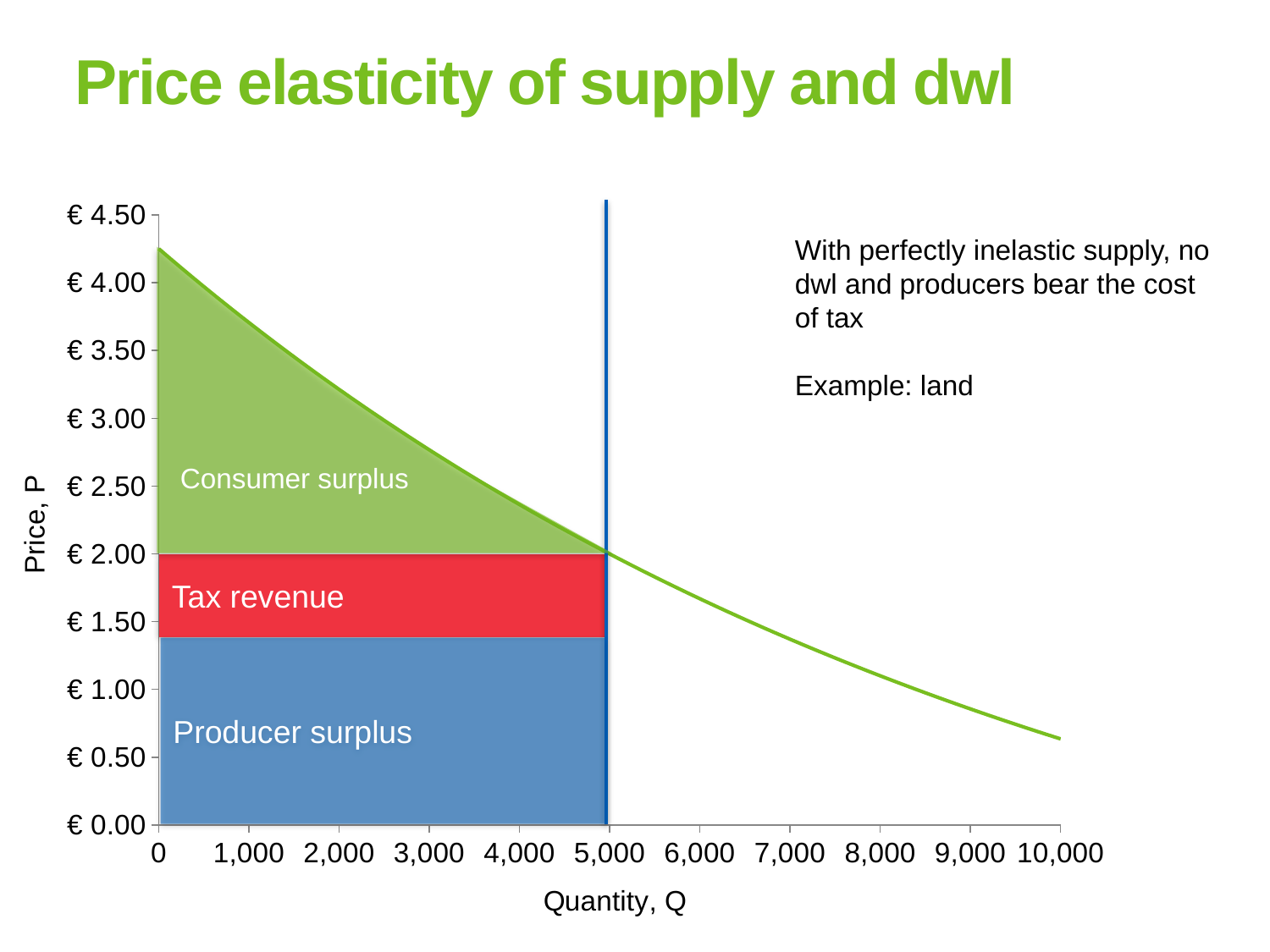
At what price does the green demand curve cross the vertical supply line? € 2.00 Does the green demand curve rise or fall as quantity increases? fall Is the price at which the demand curve crosses the supply line greater or less than € 2.50? less At what quantity is the vertical blue supply line drawn? 5,000 Is the price on the demand curve at a quantity of 10,000 greater or less than € 1.00? less Which labelled region lies between Consumer surplus and Producer surplus? Tax revenue Is the price on the demand curve at a quantity of 2,000 greater or less than € 3.00? greater What is the label of the horizontal axis? Quantity, Q How many labelled shaded regions are there in the chart? 3